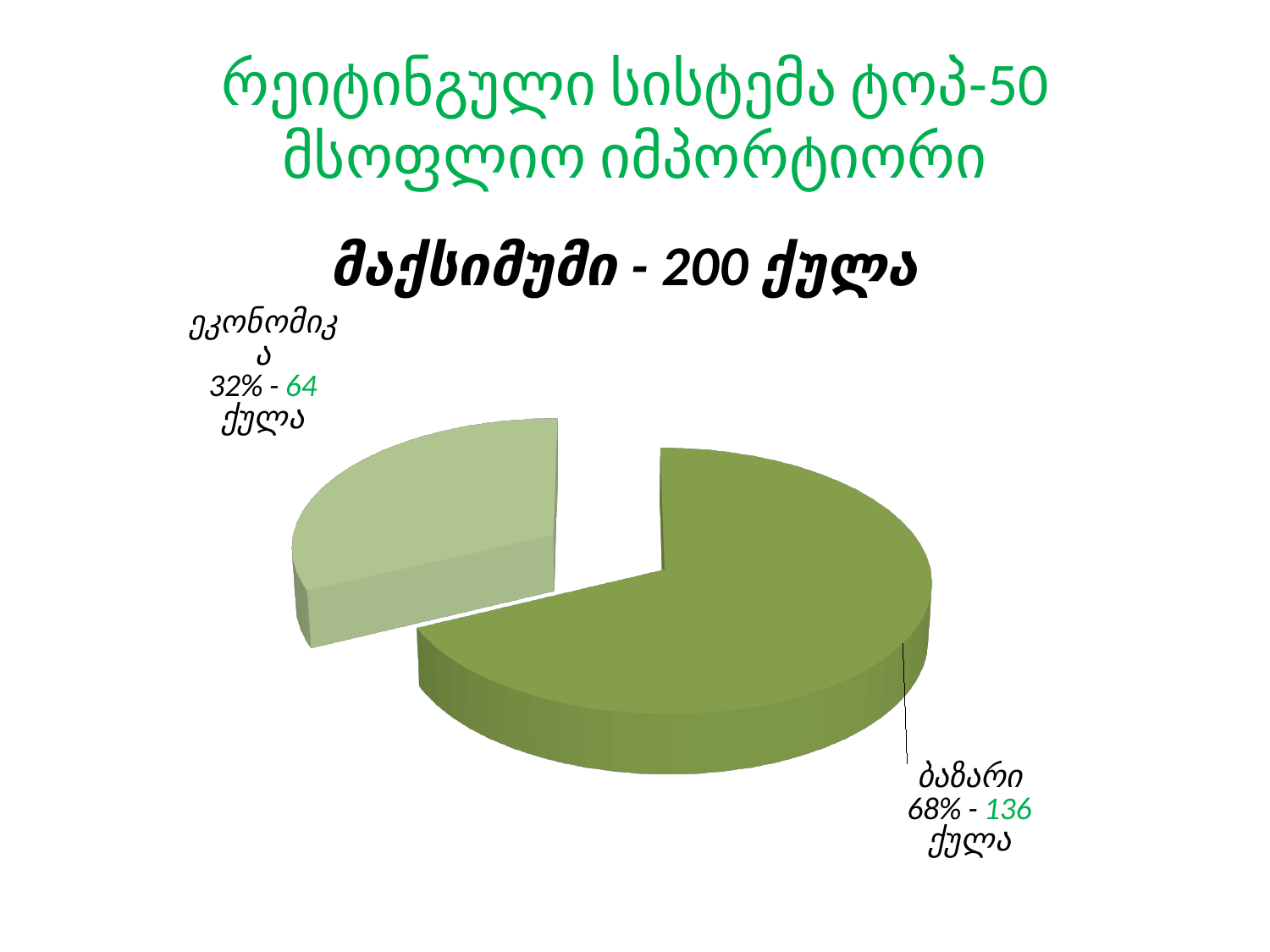
Which slice is the largest in the pie chart? ბაზარი What share of the pie does the ბაზარი (market) slice represent? 68% How many slices does the pie chart have? 2 What share of the pie does the ეკონომიკა (economy) slice represent? 32% Which slice is the smallest in the pie chart? ეკონომიკა How many points (ქულა) are assigned to ეკონომიკა (economy)? 64 What is the difference in points between ბაზარი (136) and ეკონომიკა (64)? 72 What is the total number of points across both slices? 200 What is the chart's title? მაქსიმუმი - 200 ქულა How many points (ქულა) are assigned to ბაზარი (market)? 136 Which has more points, ბაზარი or ეკონომიკა? ბაზარი What kind of chart is shown on the slide? pie chart